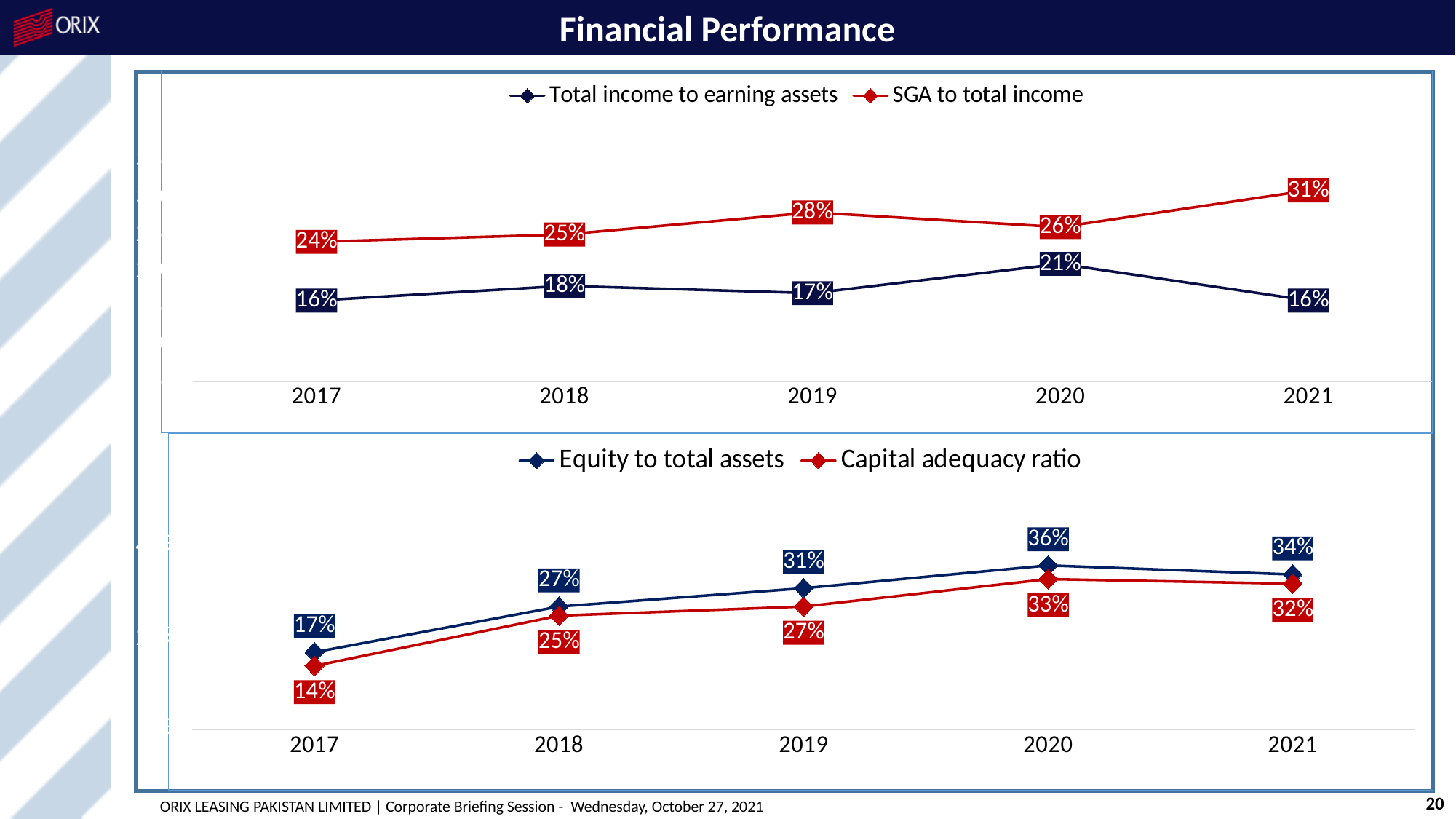
In the top chart, what kind of chart is shown? Line chart In the top chart, which year has the highest SGA to total income? 2021 In the bottom chart, which is larger in 2019: Equity to total assets or Capital adequacy ratio? Equity to total assets In the bottom chart, what is the Capital adequacy ratio in 2018? 25% In the top chart, what is the value of SGA to total income in 2019? 28% In the top chart, what is the value of Total income to earning assets in 2020? 21% In the bottom chart, which year has the lowest Capital adequacy ratio? 2017 In the top chart, what is the difference between SGA to total income and Total income to earning assets in 2021? 15% In the bottom chart, how many years are shown on the x axis? 5 In the top chart, how many series does the legend list? 2 In the bottom chart, does Equity to total assets rise or fall from 2017 to 2020? Rise In the bottom chart, what is Equity to total assets in 2020? 36%